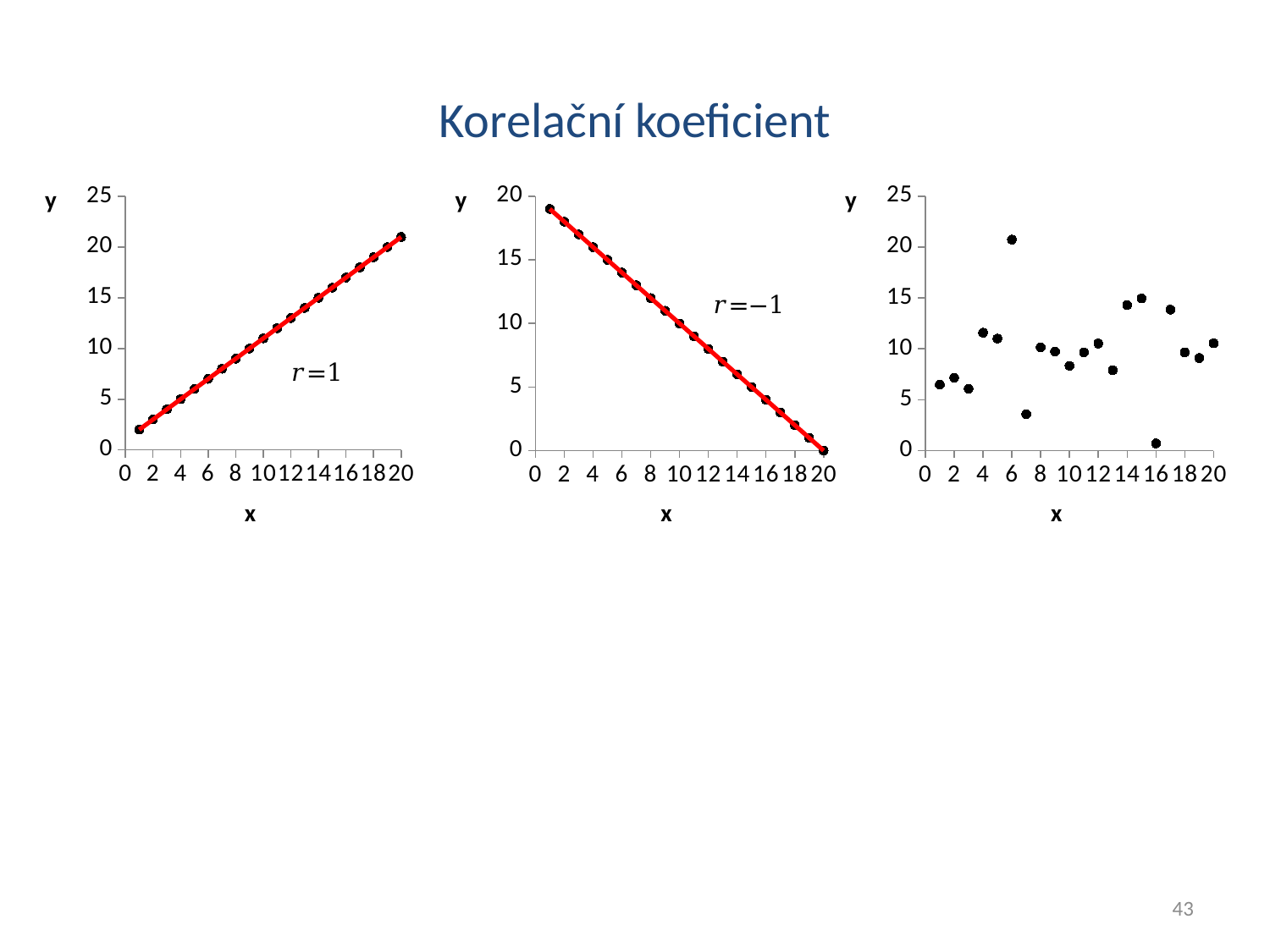
In the left chart (r=1), do the y values rise or fall as x increases? rise In the right chart, at which x value is the highest y value plotted? 6 In the middle chart (r=−1), is the y value at x=18 greater or less than 5? less In the middle chart (r=−1), is the y value at x=2 greater or less than 15? greater In the right chart, is the y value at x=6 greater or less than 15? greater In the right chart, which has the larger y value: the point at x=6 or the point at x=16? x=6 What correlation coefficient is annotated on the middle chart? r=−1 What kind of chart is the left chart (labelled r=1)? scatter chart In the right chart, at which x value is the lowest y value plotted? 16 In the middle chart (r=−1), do the y values rise or fall as x increases? fall